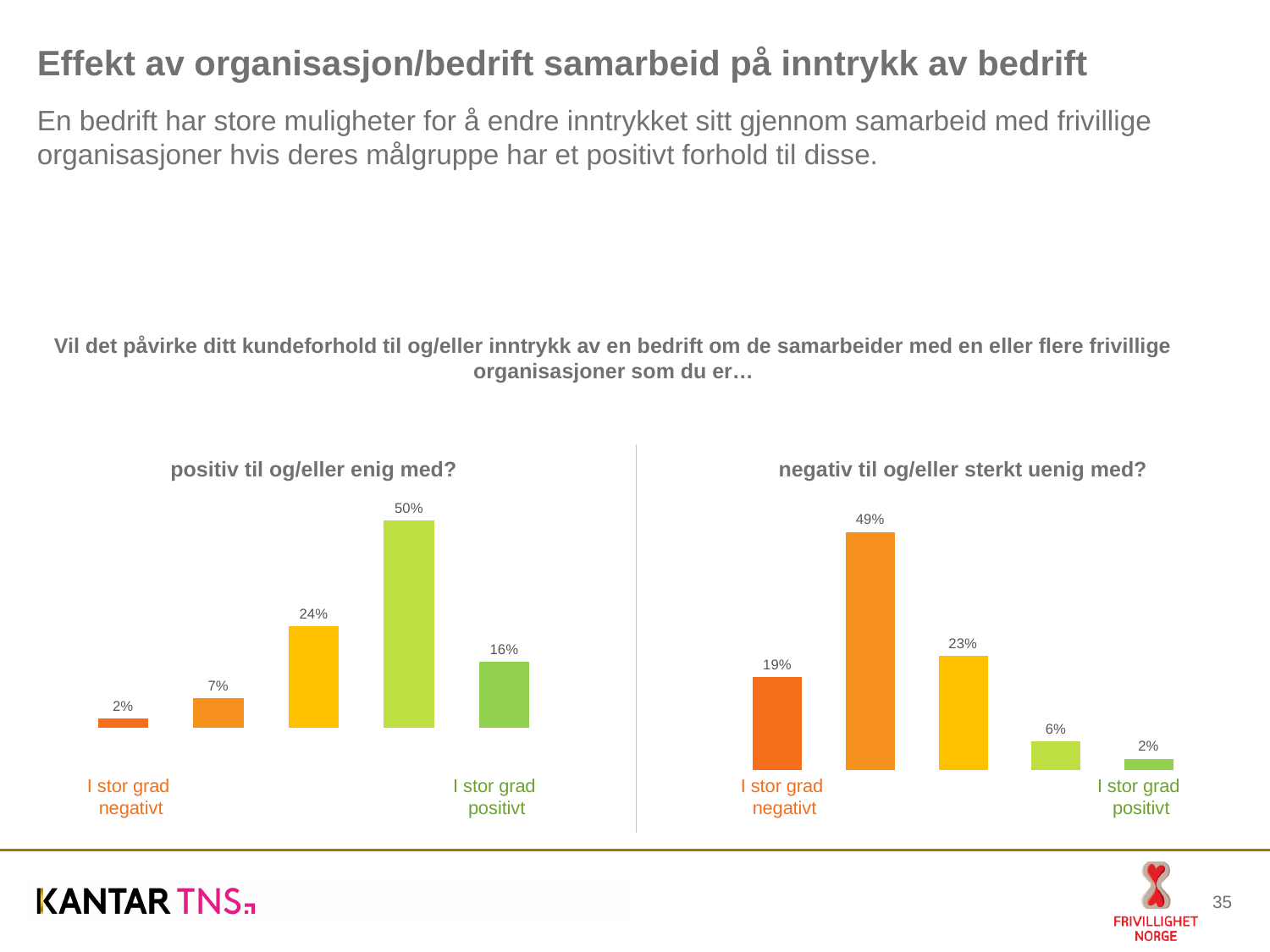
In the chart titled "negativ til og/eller sterkt uenig med?", which category has the lowest value? I stor grad positivt In the chart titled "positiv til og/eller enig med?", what is the difference between the value for "I stor grad positivt" and the value for "I stor grad negativt"? 14% What kind of chart is the chart titled "negativ til og/eller sterkt uenig med?"? Bar chart In the chart titled "negativ til og/eller sterkt uenig med?", what is the value for "I stor grad negativt"? 19% In the chart titled "positiv til og/eller enig med?", what is the value for "I stor grad negativt"? 2% In the chart titled "positiv til og/eller enig med?", what is the value for "I stor grad positivt"? 16% In the chart titled "negativ til og/eller sterkt uenig med?", what is the value of the tallest bar? 49% In the chart titled "positiv til og/eller enig med?", what is the value of the tallest bar? 50% In the chart titled "negativ til og/eller sterkt uenig med?", which is larger: the value for "I stor grad negativt" or the value for "I stor grad positivt"? I stor grad negativt In the chart titled "negativ til og/eller sterkt uenig med?", what is the value for "I stor grad positivt"? 2% In the chart titled "positiv til og/eller enig med?", what is the value of the second bar from the left? 7% How many bars are in the chart titled "positiv til og/eller enig med?"? 5